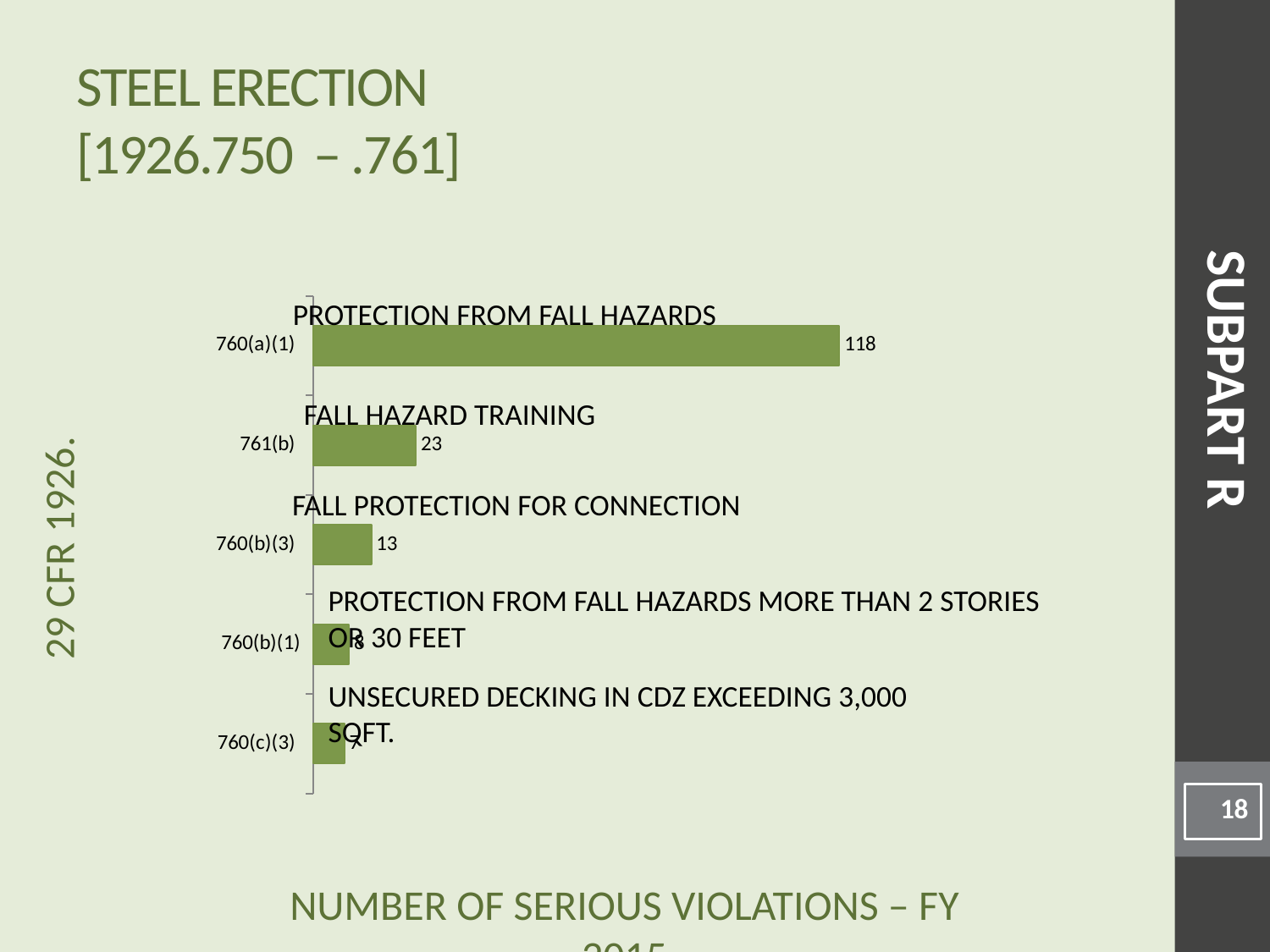
What is the difference between the values for 761(b) and 760(b)(3)? 10 Which has more serious violations, 760(a)(1) or 760(b)(1)? 760(a)(1) What is the number of serious violations for 760(a)(1)? 118 What is the difference between the values for 760(a)(1) and 761(b)? 95 What is the difference between the values for 760(a)(1) and 760(b)(3)? 105 What is the number of serious violations for 761(b)? 23 Which standard has the highest number of serious violations? 760(a)(1) What is the number of serious violations for 760(b)(3)? 13 How many standards (categories) are shown in the chart? 5 Which has more serious violations, 761(b) or 760(b)(3)? 761(b) What type of chart is shown on the slide? Bar chart What description is given for the 761(b) bar? FALL HAZARD TRAINING